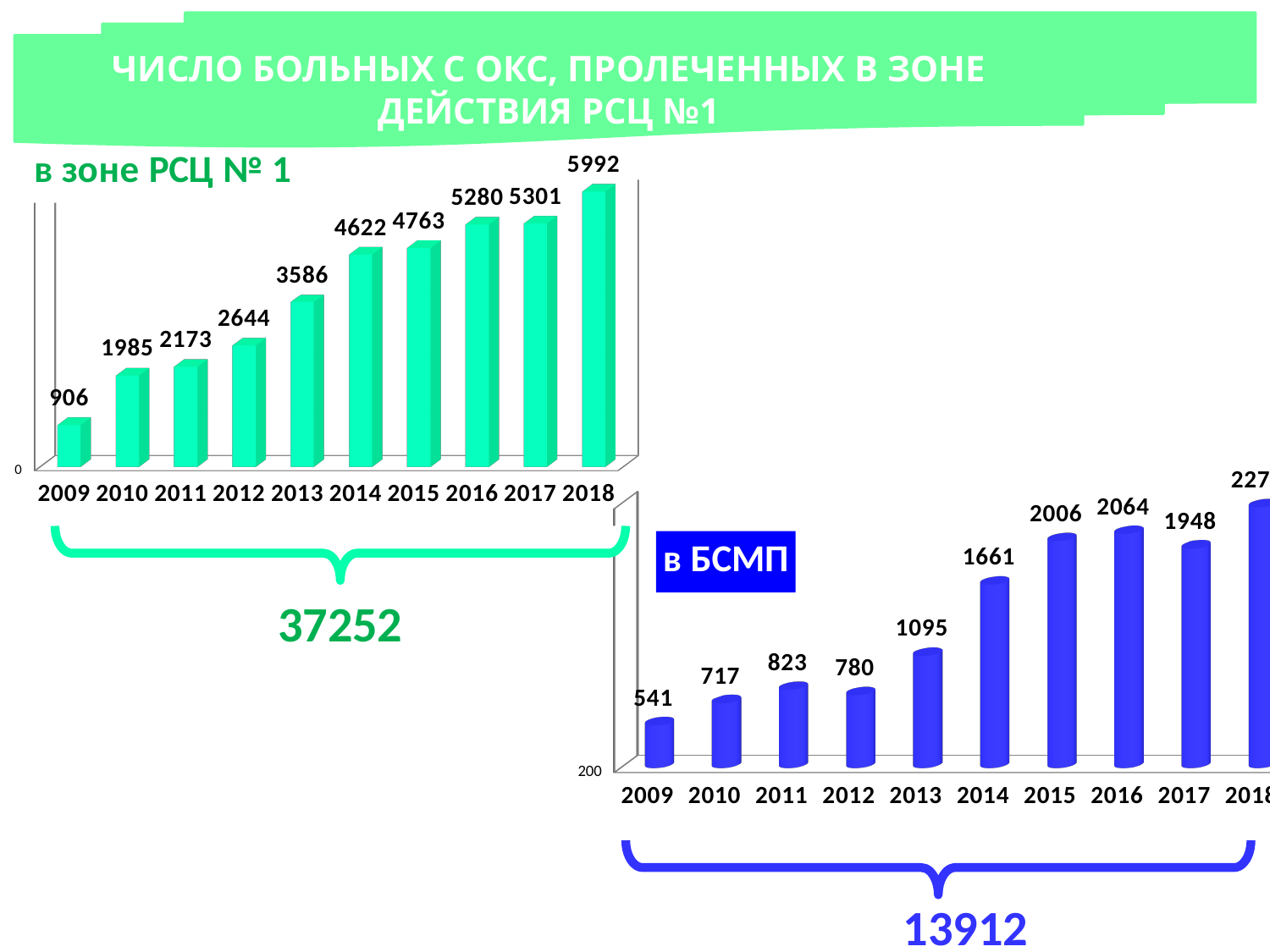
What kind of chart is 'в зоне РСЦ № 1'? bar chart In the chart 'в БСМП', what is the difference between the values for 2016 and 2015? 58 In the chart 'в БСМП', which is larger, the value for 2011 or the value for 2012? 2011 In the chart 'в БСМП', what is the value for 2012? 780 In the chart 'в зоне РСЦ № 1', how many years are shown on the x axis? 10 In the chart 'в БСМП', what is the value for 2014? 1661 In the chart 'в БСМП', which year has the lowest value? 2009 In the chart 'в зоне РСЦ № 1', which year has the lowest value? 2009 In the chart 'в зоне РСЦ № 1', what is the value for 2013? 3586 In the chart 'в зоне РСЦ № 1', what is the value for 2009? 906 In the chart 'в зоне РСЦ № 1', which year has the highest value? 2018 In the chart 'в зоне РСЦ № 1', what is the difference between the values for 2018 and 2017? 691